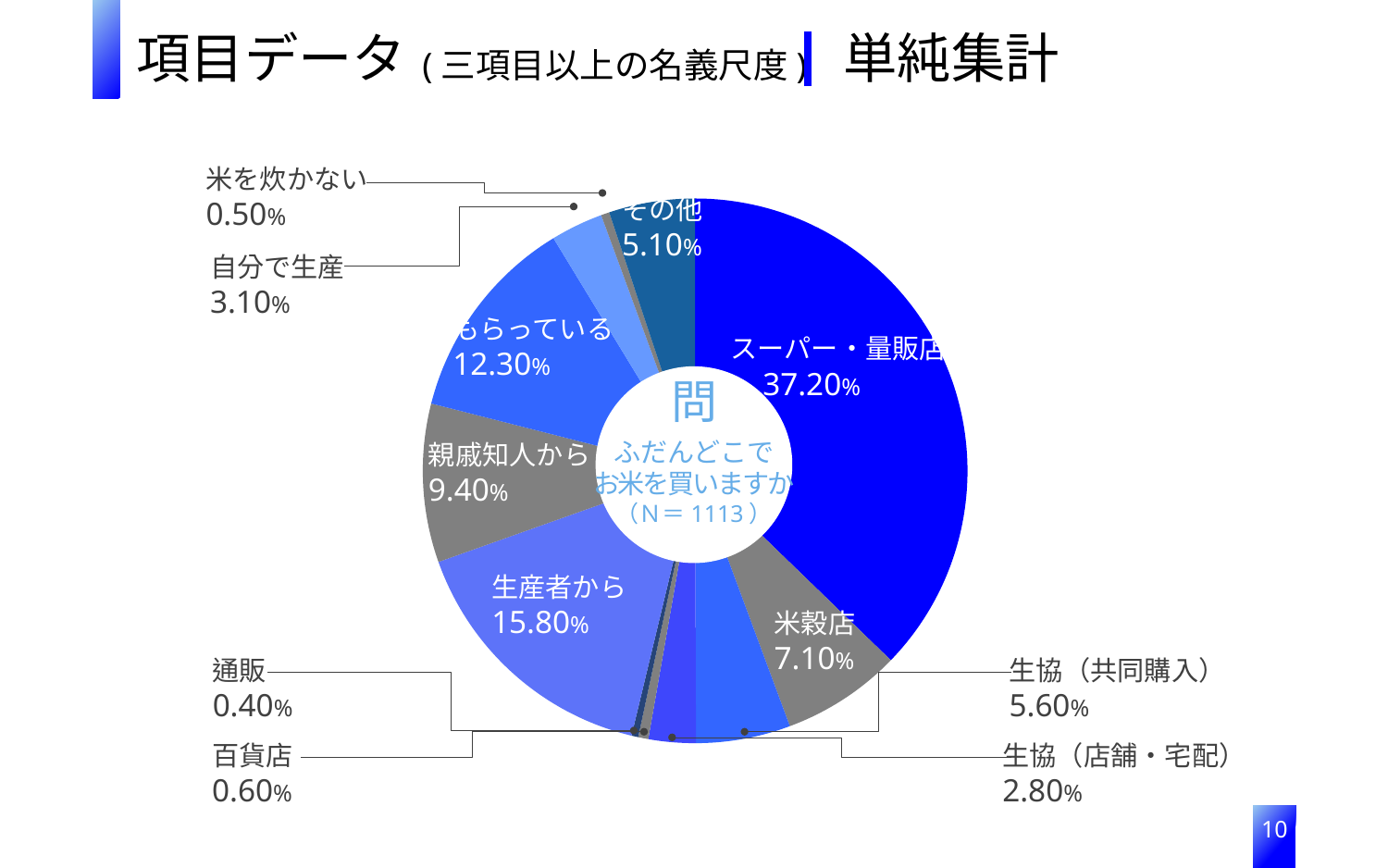
What is the difference between the values for もらっている and 親戚知人から? 2.90% How many categories are shown in the pie chart? 12 Which category has the largest share of the pie? スーパー・量販店 Which category has the smallest share of the pie? 通販 What kind of chart is shown on the slide? Pie chart (donut) What is the value for スーパー・量販店? 37.20% What question is written in the centre of the chart? ふだんどこでお米を買いますか What is the sample size (N) shown in the centre of the chart? 1113 Which is larger, the value for 米穀店 or the value for 生協（共同購入）? 米穀店 What is the value for 生協（店舗・宅配）? 2.80% What is the value for 生産者から? 15.80% What is the value for 米を炊かない? 0.50%